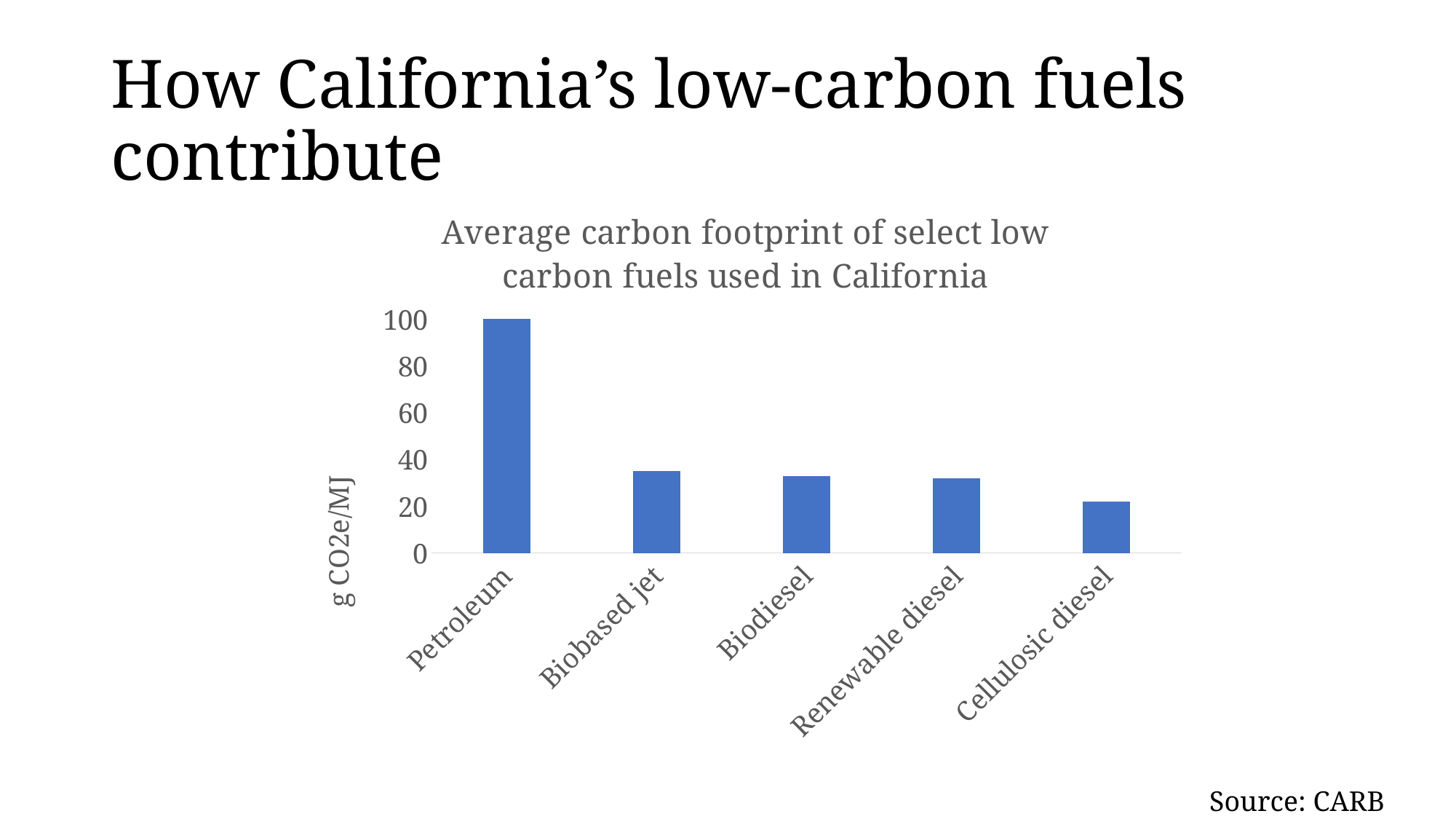
How many fuel categories are plotted in the chart? 5 What is the title of the chart? Average carbon footprint of select low carbon fuels used in California Is the value for Renewable diesel greater or less than 20? greater Is the value for Petroleum greater or less than 80? greater Is the value for Cellulosic diesel greater or less than 40? less Which has a larger carbon footprint, Biobased jet or Cellulosic diesel? Biobased jet Which fuel has the highest average carbon footprint in the chart? Petroleum What kind of chart is shown on the slide? Bar chart Which has a larger carbon footprint, Petroleum or Biodiesel? Petroleum What unit is shown on the chart's vertical axis label? g CO2e/MJ Which fuel has the lowest average carbon footprint in the chart? Cellulosic diesel